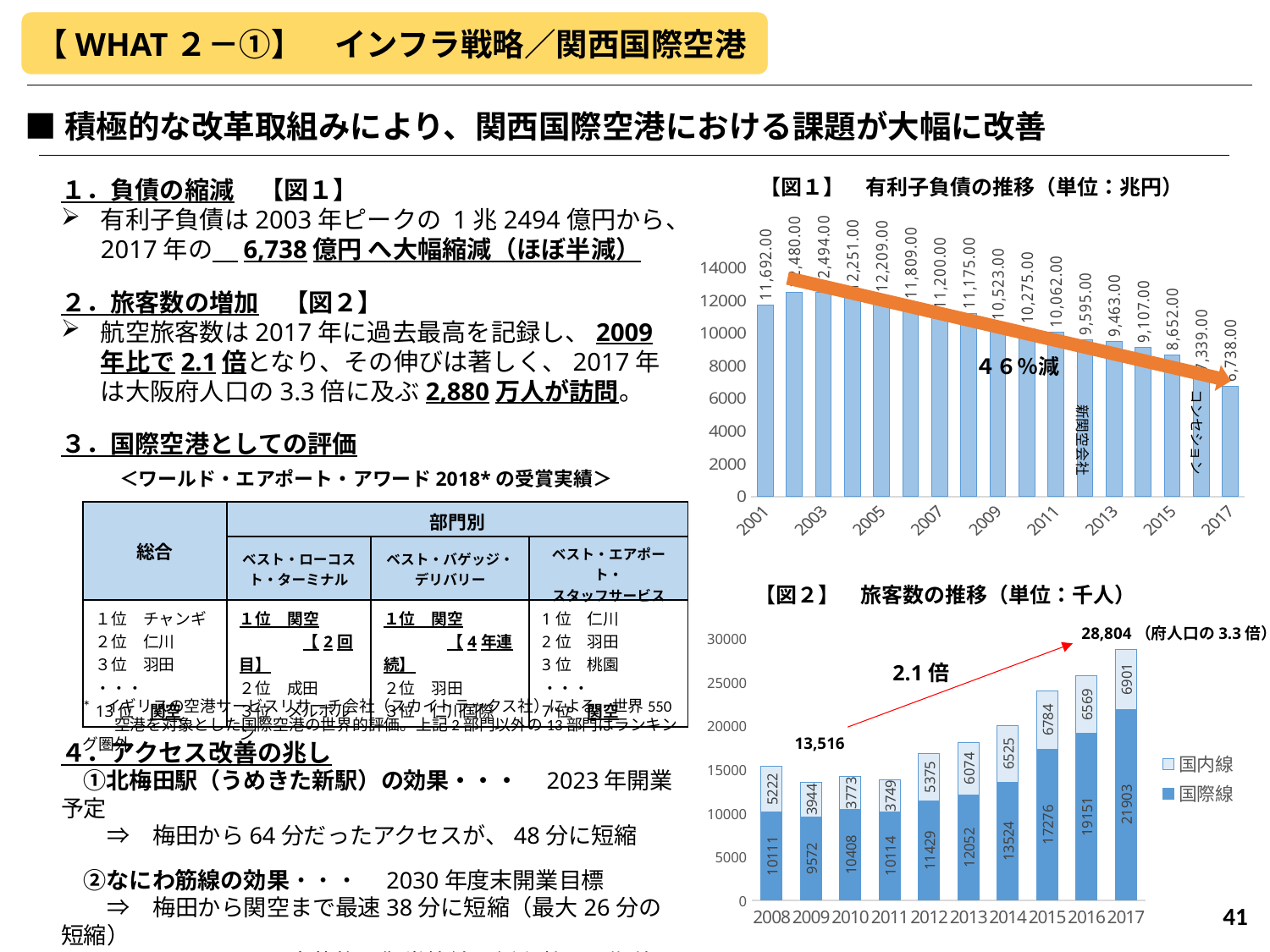
In 【図２】 旅客数の推移, what is the total of the stacked bar for 2017? 28,804 In 【図１】 有利子負債の推移, how many years (bars) are plotted? 17 In 【図２】 旅客数の推移, what is the difference between the 国際線 values for 2017 and 2016? 2752 In 【図２】 旅客数の推移, what is the 国際線 value for 2017? 21903 In 【図２】 旅客数の推移, how many series does the legend list? 2 In 【図２】 旅客数の推移, which is larger: the 国内線 value for 2015 or for 2016? 2015 In 【図１】 有利子負債の推移, do the values generally rise or fall from 2003 to 2017? fall In 【図１】 有利子負債の推移, which year has the lowest value? 2017 In 【図１】 有利子負債の推移, is the value for 2013 greater or less than 10000? less In 【図１】 有利子負債の推移, what is the value for 2009? 10,523.00 What type of chart is 【図１】 有利子負債の推移? bar chart In 【図１】 有利子負債の推移, what is the value for 2001? 11,692.00